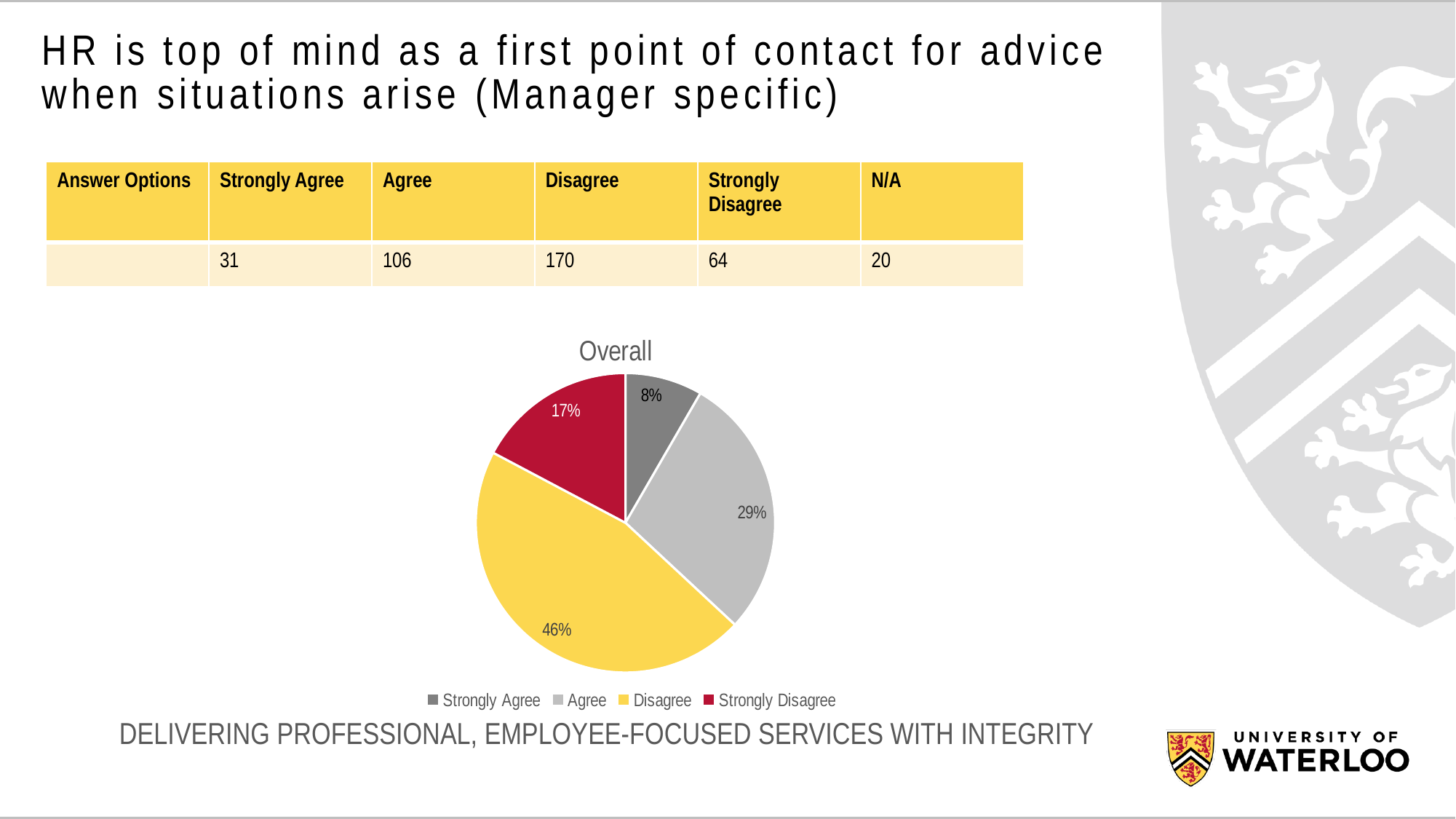
How many slices does the pie chart have? 4 What is the difference in percentage points between the Disagree slice and the Agree slice? 17 What percentage of the pie chart is labelled for Disagree? 46% How many entries does the pie chart's legend list? 4 What kind of chart is shown on the slide? Pie chart Which slice is larger in the pie chart, Strongly Disagree or Strongly Agree? Strongly Disagree What is the title of the pie chart? Overall Which category has the smallest slice in the pie chart? Strongly Agree What percentage of the pie chart is labelled for Strongly Agree? 8% Which category has the largest slice in the pie chart? Disagree What percentage of the pie chart is labelled for Agree? 29% What percentage of the pie chart is labelled for Strongly Disagree? 17%